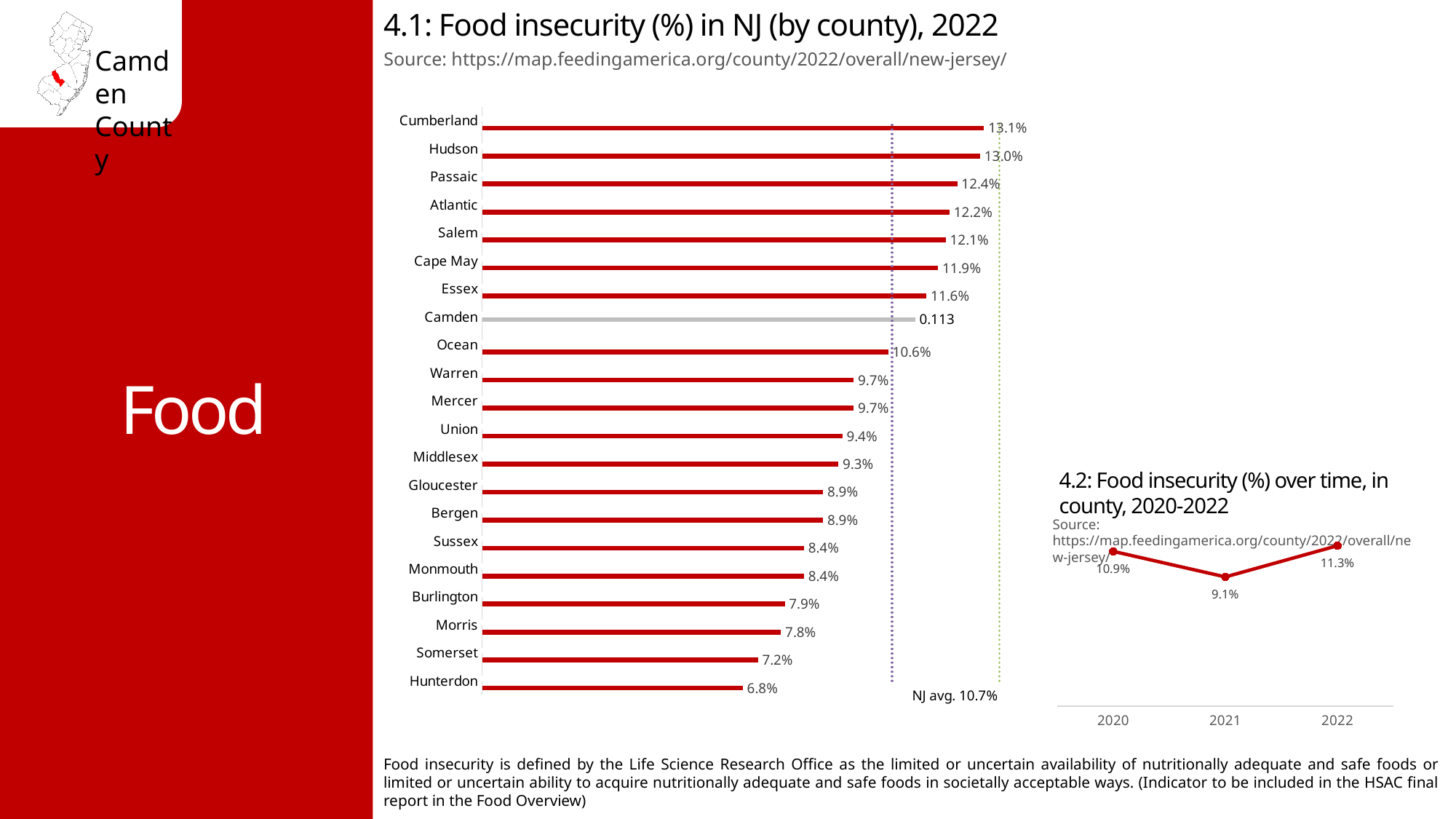
In chart 4.1 (Food insecurity in NJ by county, 2022), what is the difference between Cumberland's and Hunterdon's values? 6.3 percentage points In chart 4.2 (Food insecurity over time in county, 2020-2022), what is the difference between the 2022 and 2020 values? 0.4 percentage points In chart 4.1 (Food insecurity in NJ by county, 2022), which county has the highest food insecurity rate? Cumberland In chart 4.1 (Food insecurity in NJ by county, 2022), what is the value for Cumberland? 13.1% In chart 4.2 (Food insecurity over time in county, 2020-2022), how does the value change from 2020 to 2022? It falls in 2021, then rises in 2022 In chart 4.1 (Food insecurity in NJ by county, 2022), what NJ average is noted on the chart? NJ avg. 10.7% In chart 4.1 (Food insecurity in NJ by county, 2022), which has the higher value, Passaic or Atlantic? Passaic In chart 4.1 (Food insecurity in NJ by county, 2022), which county has the lowest food insecurity rate? Hunterdon In chart 4.2 (Food insecurity over time in county, 2020-2022), what is the value for 2021? 9.1% In chart 4.1 (Food insecurity in NJ by county, 2022), how many counties are shown? 21 What kind of chart is chart 4.1 (Food insecurity in NJ by county, 2022)? Bar chart In chart 4.1 (Food insecurity in NJ by county, 2022), what label is printed for Camden's bar? 0.113